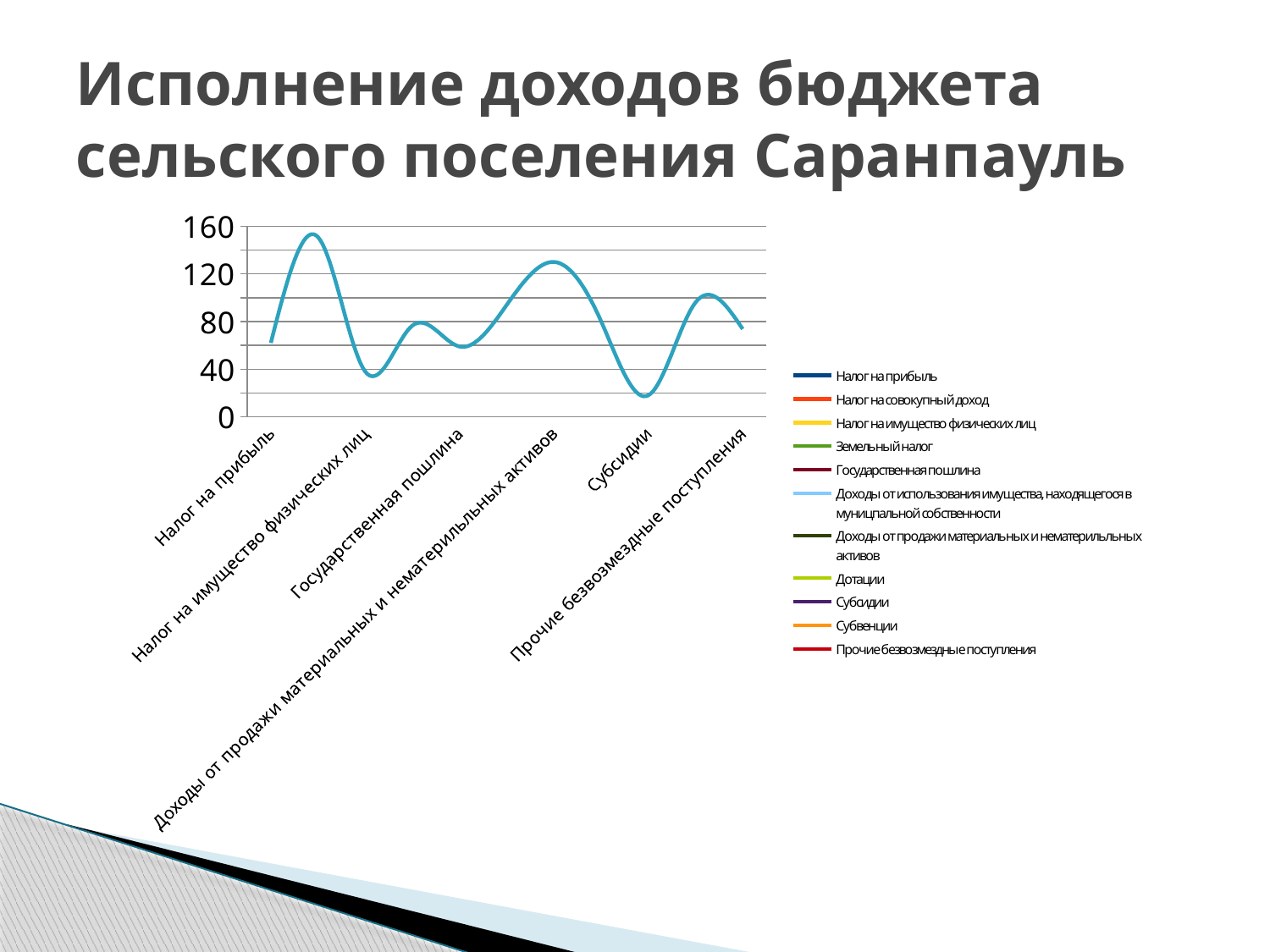
Is the value for Доходы от продажи материальных и нематерильных активов greater or less than 120? greater Is the value for Субсидии greater or less than 40? less What kind of chart is shown on the slide? line chart Among the categories labelled on the x axis, which has the lowest value? Субсидии Is the value for Прочие безвозмездные поступления greater or less than 40? greater Which has the larger value: Налог на прибыль or Налог на имущество физических лиц? Налог на прибыль Which has the larger value: Доходы от продажи материальных и нематерильных активов or Субсидии? Доходы от продажи материальных и нематерильных активов How many entries does the chart legend list? 11 What is the title of the slide containing the chart? Исполнение доходов бюджета сельского поселения Саранпауль